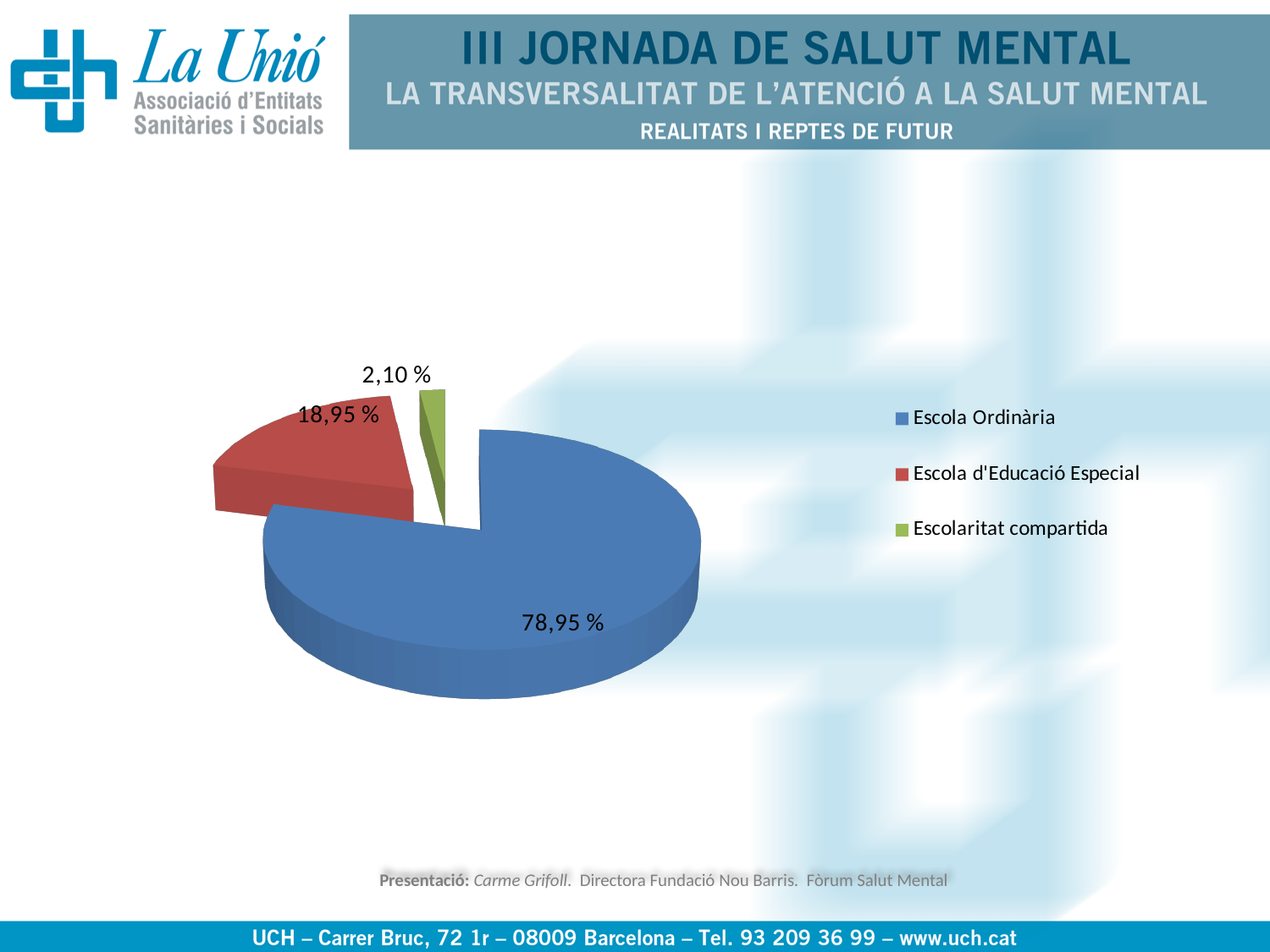
How many entries does the legend list? 3 What is the value for Escola d'Educació Especial? 18,95 % Which category has the smallest slice of the pie? Escolaritat compartida What is the difference between the values for Escola Ordinària and Escola d'Educació Especial? 60,00 % What is the value for Escolaritat compartida? 2,10 % How many categories does the pie chart show? 3 What colour is the slice for Escola d'Educació Especial? Red Which is larger, the value for Escola d'Educació Especial or the value for Escolaritat compartida? Escola d'Educació Especial What is the difference between the values for Escola d'Educació Especial and Escolaritat compartida? 16,85 % What kind of chart is shown on the slide? Pie chart What is the value for Escola Ordinària? 78,95 % Which category has the largest slice of the pie? Escola Ordinària